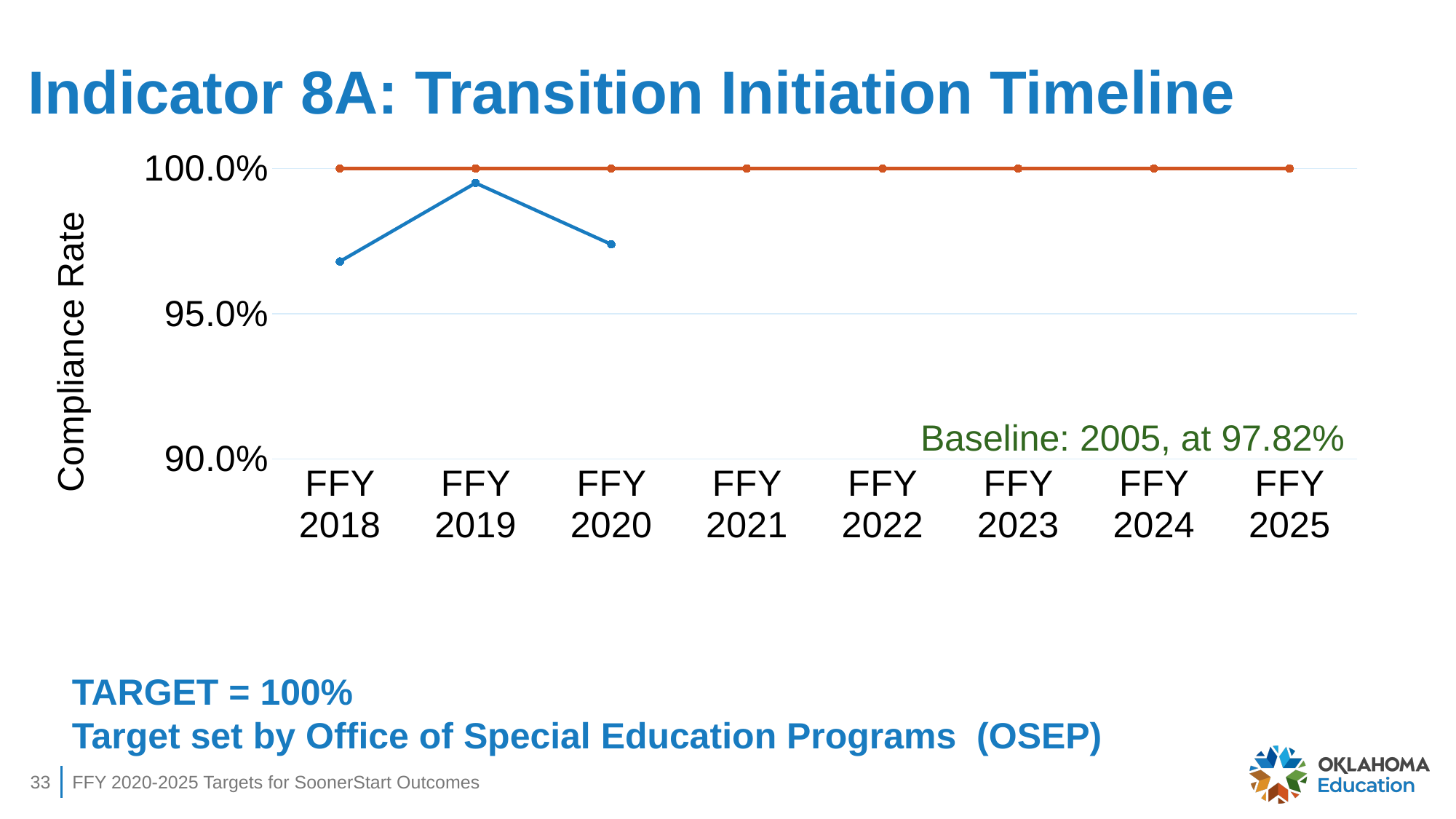
What is the label on the y axis of the chart? Compliance Rate Does the blue line rise or fall from FFY 2019 to FFY 2020? fall On the blue line, is the value for FFY 2019 larger or smaller than the value for FFY 2018? larger What kind of chart is shown on the slide? Line chart What is the target compliance rate shown by the flat orange line? 100% Is the blue line's value for FFY 2018 greater or less than 95.0%? greater How many lines are plotted on the chart? 2 For how many FFY years does the blue line have a plotted point? 3 How many FFY categories are shown on the x axis? 8 Which FFY year has the lowest value on the blue line? FFY 2018 Which FFY year has the highest value on the blue line? FFY 2019 Is the blue line's value for FFY 2020 greater or less than 95.0%? greater